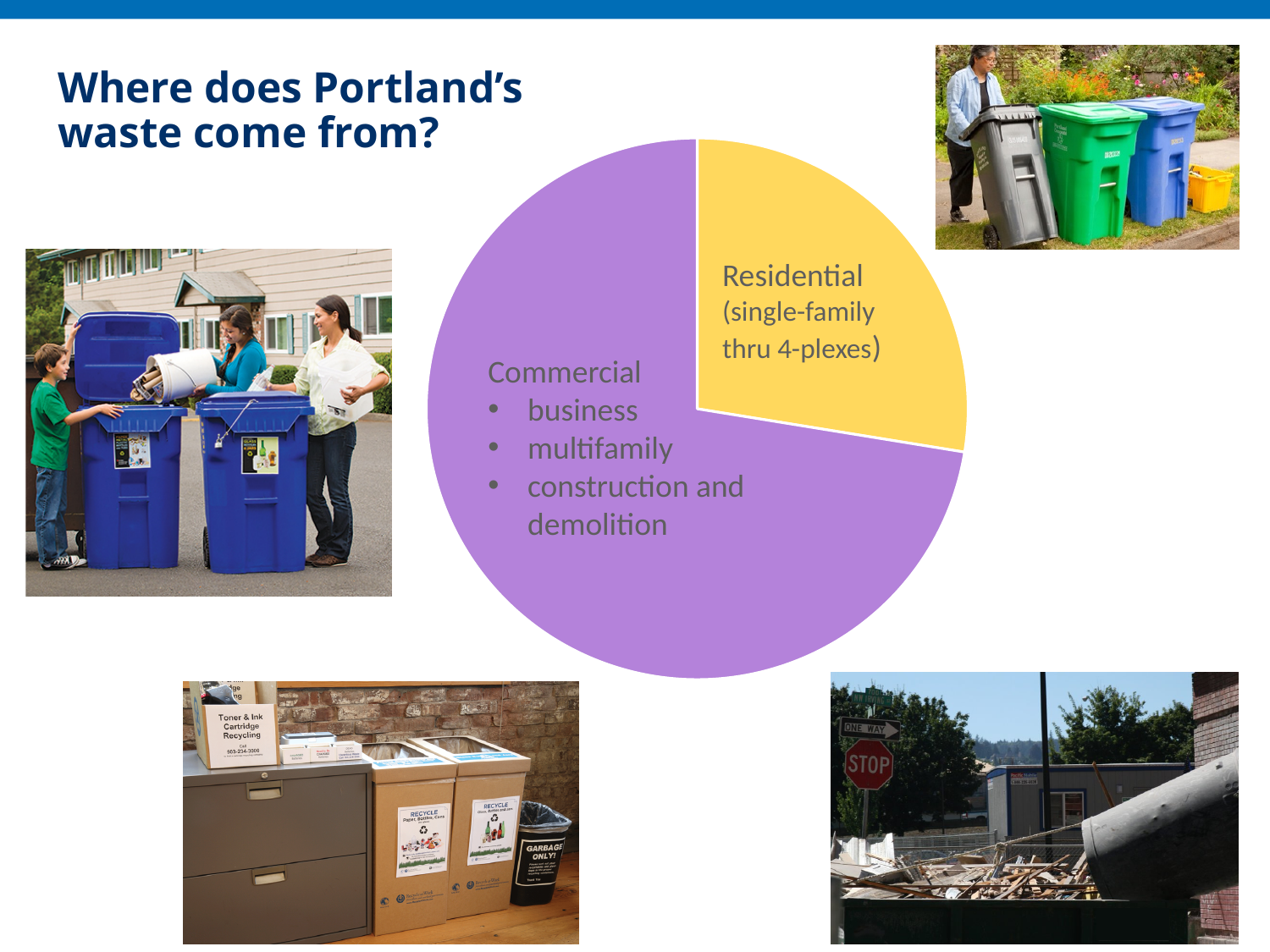
What kind of chart is shown on the slide? pie chart Which slice of the pie chart is the smallest? Residential Does the Residential slice make up more or less than half of the pie chart? less Which is larger in the pie chart, the Commercial slice or the Residential slice? Commercial What colour is the Residential slice of the pie chart? yellow What is the title of the slide containing the pie chart? Where does Portland's waste come from? Which slice of the pie chart is the largest? Commercial Does the Commercial slice make up more or less than half of the pie chart? more How many slices does the pie chart have? 2